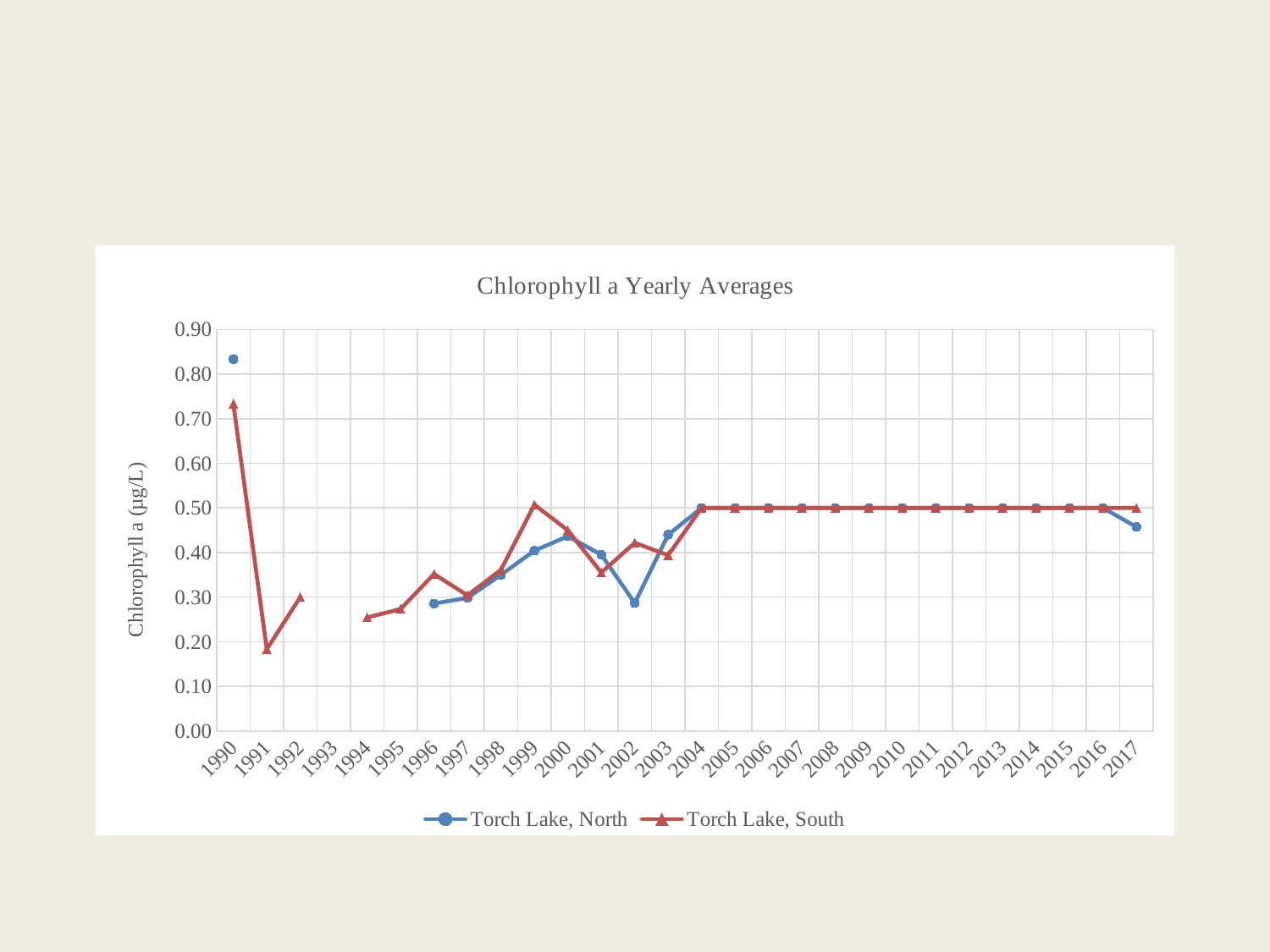
What kind of chart is shown on the slide? Line chart What is the label on the vertical axis? Chlorophyll a (µg/L) In which year does Torch Lake, South reach its lowest value? 1991 Is the value for Torch Lake, South in 1991 greater or less than 0.20? less Is the value for Torch Lake, North in 1990 greater or less than 0.80? greater How many years are labelled along the x axis? 28 In which year does Torch Lake, North reach its highest value? 1990 Does the Torch Lake, South line rise or fall from 1994 to 1996? Rise Is the value for Torch Lake, North in 2017 greater or less than 0.50? less How many series does the legend list? 2 In 2002, which series has the larger value, Torch Lake, North or Torch Lake, South? Torch Lake, South What is the title of the chart? Chlorophyll a Yearly Averages